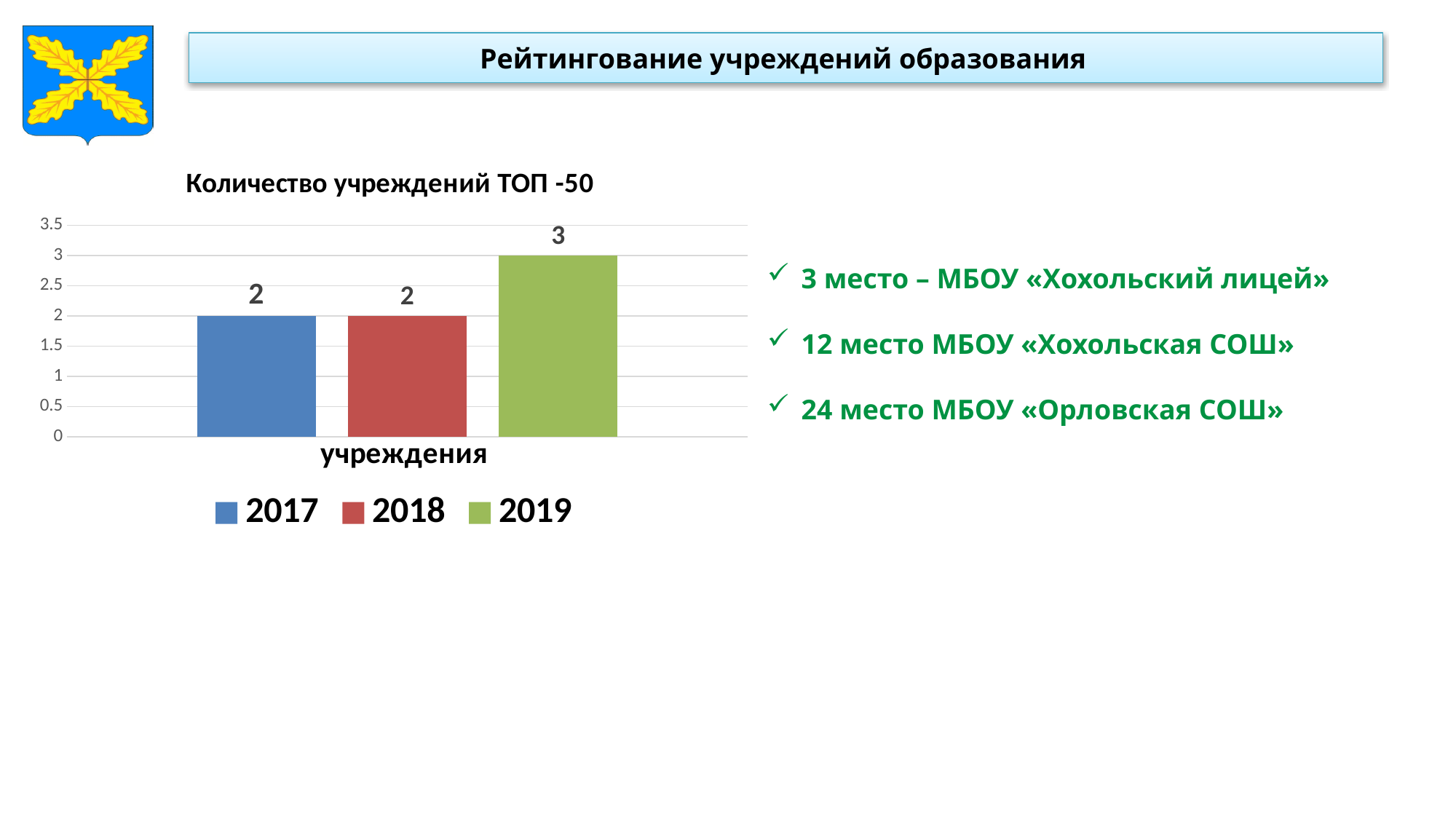
What is the value for 2018 in the chart 'Количество учреждений ТОП -50'? 2 Do the values rise or fall from 2018 to 2019? rise Is the value for 2019 greater or less than 2.5? greater Which is larger, the value for 2019 or the value for 2017? 2019 What colour is the bar for 2019? green How many series does the legend list? 3 What is the difference between the values for 2019 and 2018? 1 What is the title of the chart? Количество учреждений ТОП -50 What is the value for 2017 in the chart 'Количество учреждений ТОП -50'? 2 What is the value for 2019 in the chart 'Количество учреждений ТОП -50'? 3 Which year has the highest value in the chart? 2019 What kind of chart is shown on the slide? bar chart